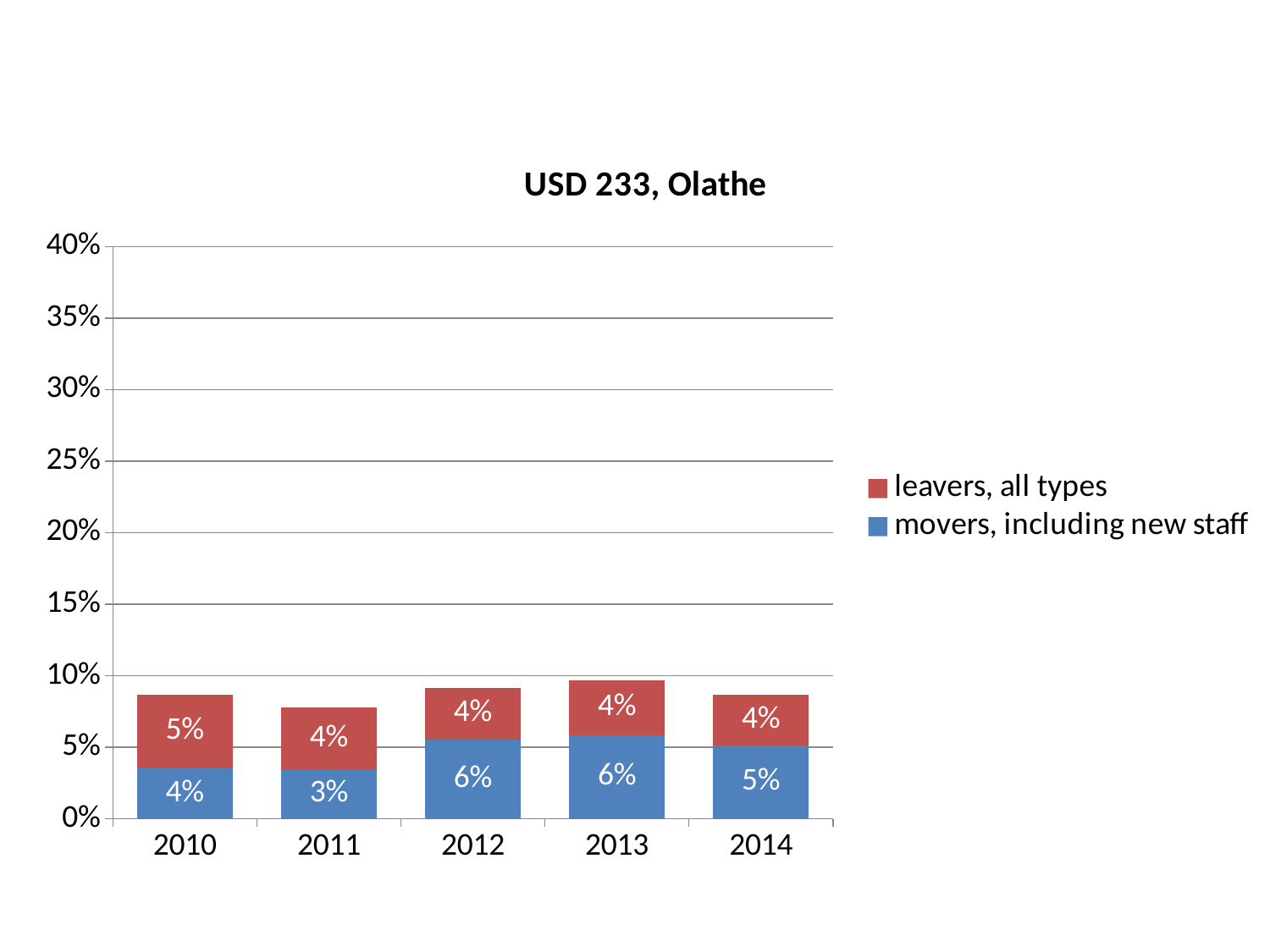
What is the value for movers, including new staff in 2012? 6% What is the value for leavers, all types in 2010? 5% Which year has the lowest value for movers, including new staff? 2011 What is the value for movers, including new staff in 2011? 3% Is the total height of the 2013 stacked bar greater or less than 10%? less In 2010, which is larger: leavers, all types or movers, including new staff? leavers, all types What is the difference between the movers, including new staff values for 2012 and 2011? 3% How many series does the legend list? 2 How many years are shown on the x axis? 5 What is the value for leavers, all types in 2014? 4% What kind of chart is shown on the slide? stacked bar chart Which year has the highest value for leavers, all types? 2010